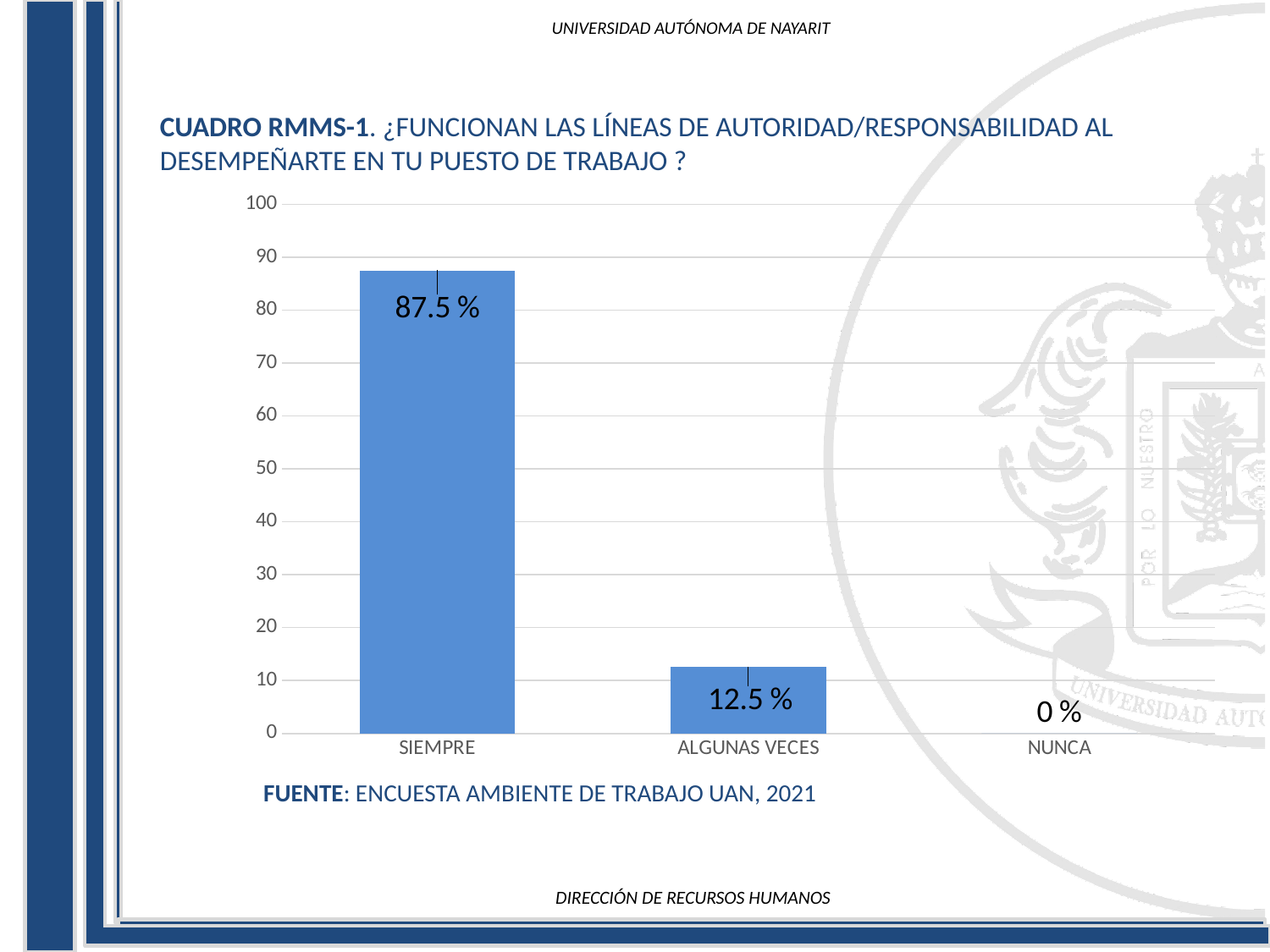
Is the value for SIEMPRE greater or less than 80? greater What source is cited below the chart? ENCUESTA AMBIENTE DE TRABAJO UAN, 2021 Which category has the highest value? SIEMPRE What is the value for NUNCA? 0 % What is the value for ALGUNAS VECES? 12.5 % What kind of chart is shown on the slide? bar chart Which is larger, the value for ALGUNAS VECES or the value for NUNCA? ALGUNAS VECES How many categories are shown on the x axis? 3 What is the difference between the values for SIEMPRE and ALGUNAS VECES? 75 % Is the value for ALGUNAS VECES greater or less than 20? less What is the value for SIEMPRE? 87.5 % Which category has the lowest value? NUNCA